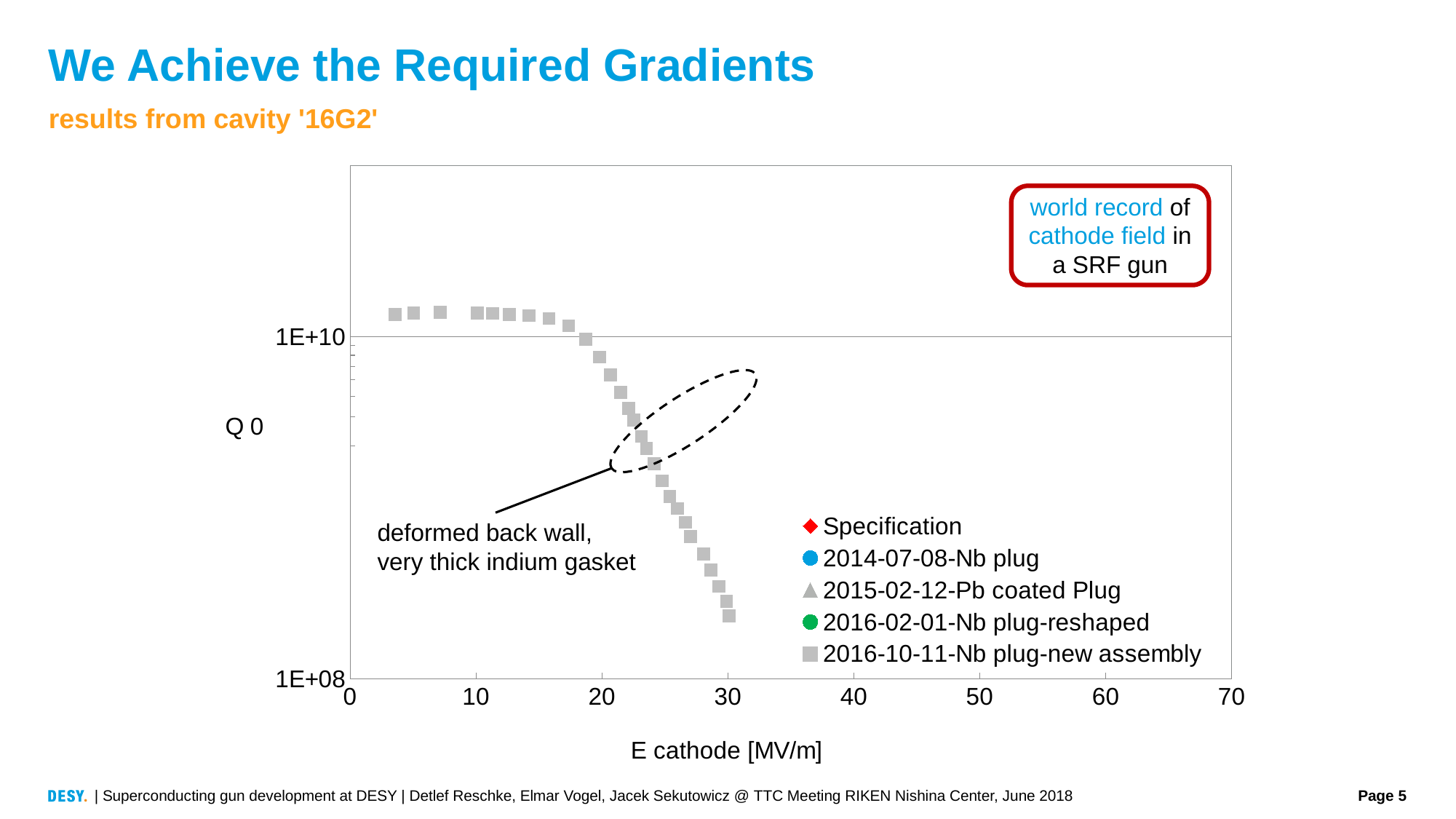
How many series does the chart legend list? 5 What is the label of the x axis? E cathode [MV/m] Is the Q 0 value at an E cathode of 30 MV/m greater or less than 1E+10? less Is the Q 0 value at an E cathode of 30 MV/m greater or less than 1E+08? greater Does Q 0 rise or fall as E cathode increases along the x axis? fall Which legend entry is shown with a red diamond marker? Specification Is the highest E cathode value reached by the plotted points greater or less than 40 MV/m? less What kind of chart is shown on the slide? scatter chart What is the maximum value shown on the x axis? 70